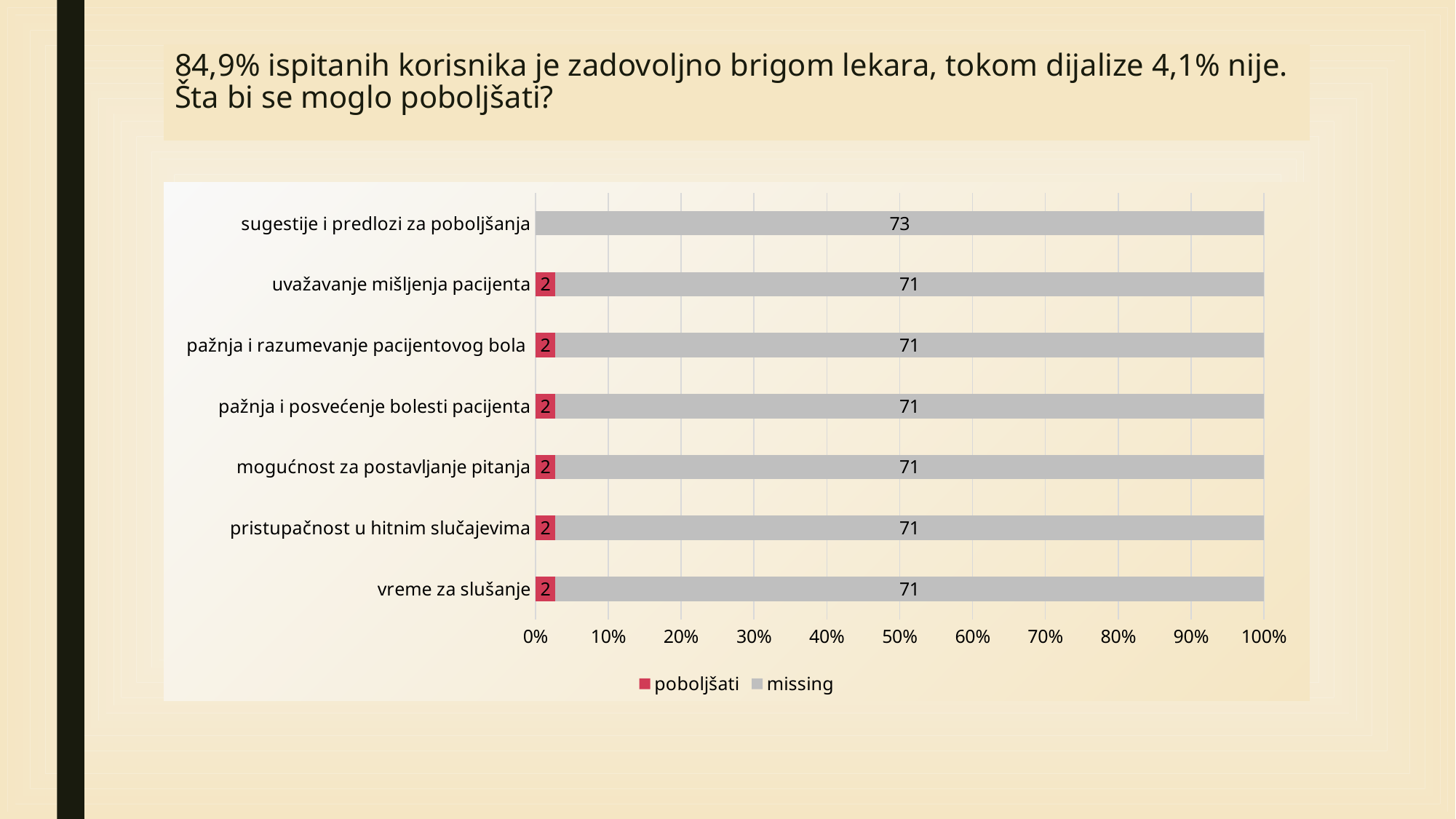
How many categories are shown on the chart? 7 Which category has the highest 'missing' value? sugestije i predlozi za poboljšanja What kind of chart is shown on the slide? stacked bar chart What is the 'missing' value for 'pristupačnost u hitnim slučajevima'? 71 How many series does the legend list? 2 What is the 'poboljšati' value for 'uvažavanje mišljenja pacijenta'? 2 Which colour represents the 'poboljšati' series in the legend? red What is the difference between the 'missing' value for 'sugestije i predlozi za poboljšanja' and the 'missing' value for 'vreme za slušanje'? 2 What is the 'poboljšati' value for 'vreme za slušanje'? 2 What is the 'missing' value for 'sugestije i predlozi za poboljšanja'? 73 What is the total of the 'poboljšati' and 'missing' values for 'mogućnost za postavljanje pitanja'? 73 Which is larger: the 'missing' value for 'pažnja i posvećenje bolesti pacijenta' or the 'poboljšati' value for the same category? missing